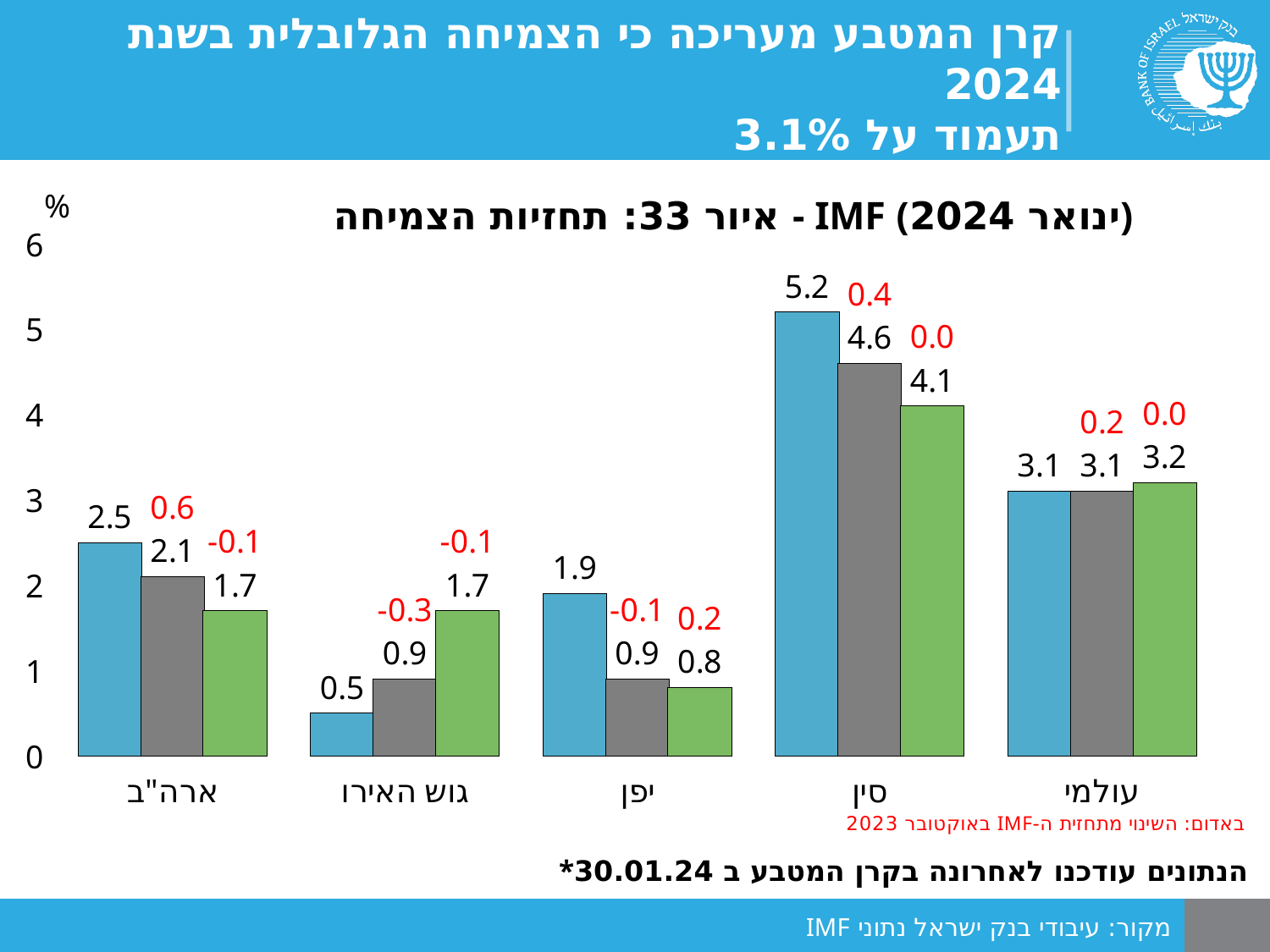
How many categories are shown on the x axis of the chart? 5 What is the value of the blue bar for סין (China)? 5.2 Which category has the lowest blue bar? גוש האירו What unit is shown at the top of the y axis of the chart? % What is the difference between the blue bar and the gray bar for סין (China)? 0.6 What is the value of the green bar for עולמי (Global)? 3.2 What is the value of the gray bar for יפן (Japan)? 0.9 What is the difference between the blue bar and the green bar for ארה"ב (USA)? 0.8 What is the value of the green bar for גוש האירו (Eurozone)? 1.7 Which category has the highest blue bar? סין Which is larger for יפן (Japan): the blue bar or the green bar? the blue bar What type of chart is shown on the slide? bar chart